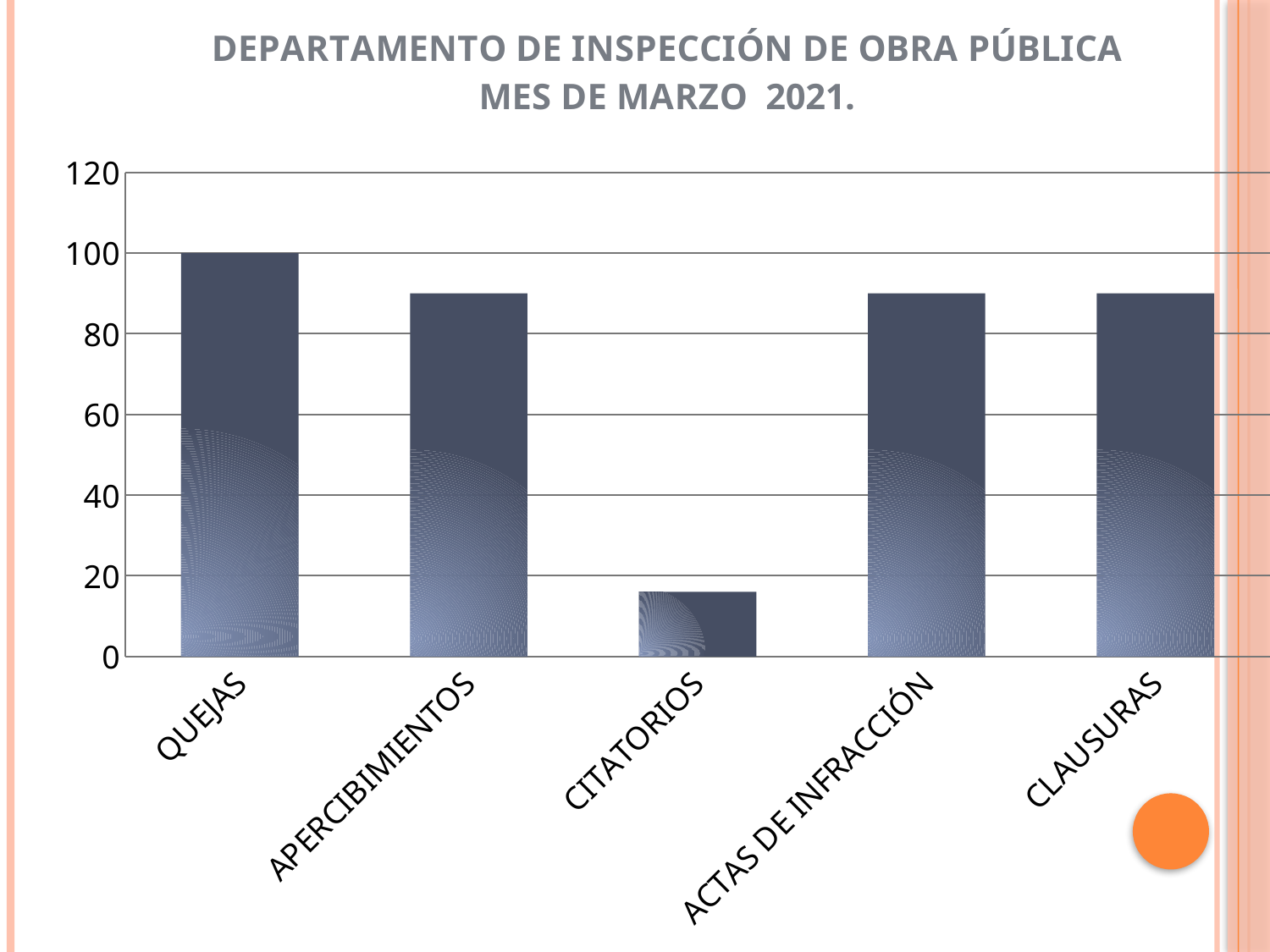
Which is larger, the value for CITATORIOS or the value for CLAUSURAS? CLAUSURAS Is the value for APERCIBIMIENTOS greater or less than 80? greater Which is larger, the value for QUEJAS or the value for CITATORIOS? QUEJAS Which category has the lowest value? CITATORIOS What is the value for QUEJAS? 100 Is the value for ACTAS DE INFRACCIÓN greater or less than 100? less What kind of chart is shown on the slide? bar chart Which category has the highest value? QUEJAS Is the value for CLAUSURAS greater or less than 60? greater What month and year does the chart title refer to? Marzo 2021 How many categories are shown on the x axis? 5